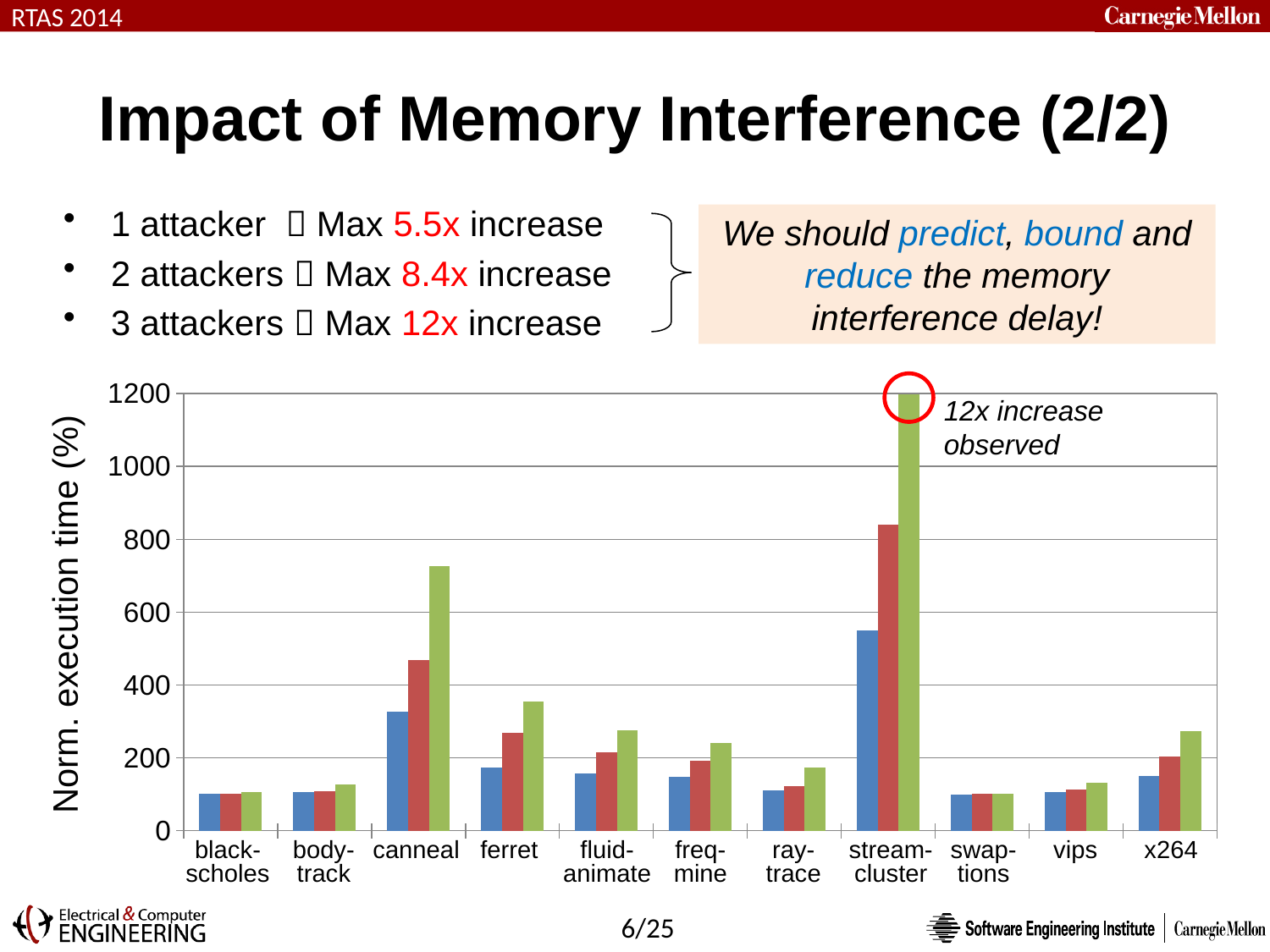
Is the value of the green bar for canneal greater or less than 600? greater Is the value of the green bar for x264 greater or less than 200? greater Which benchmark has the tallest bar in the chart? stream-cluster Is the value of the blue bar for stream-cluster greater or less than 400? greater What is the label of the y axis of the chart? Norm. execution time (%) How many bars are plotted for each benchmark category in the chart? 3 Which has the larger green bar, canneal or ferret? canneal What kind of chart is shown on the slide? bar chart What is the highest tick value shown on the y axis of the chart? 1200 How many benchmark categories are shown on the x axis of the chart? 11 Which has the larger red bar, stream-cluster or canneal? stream-cluster